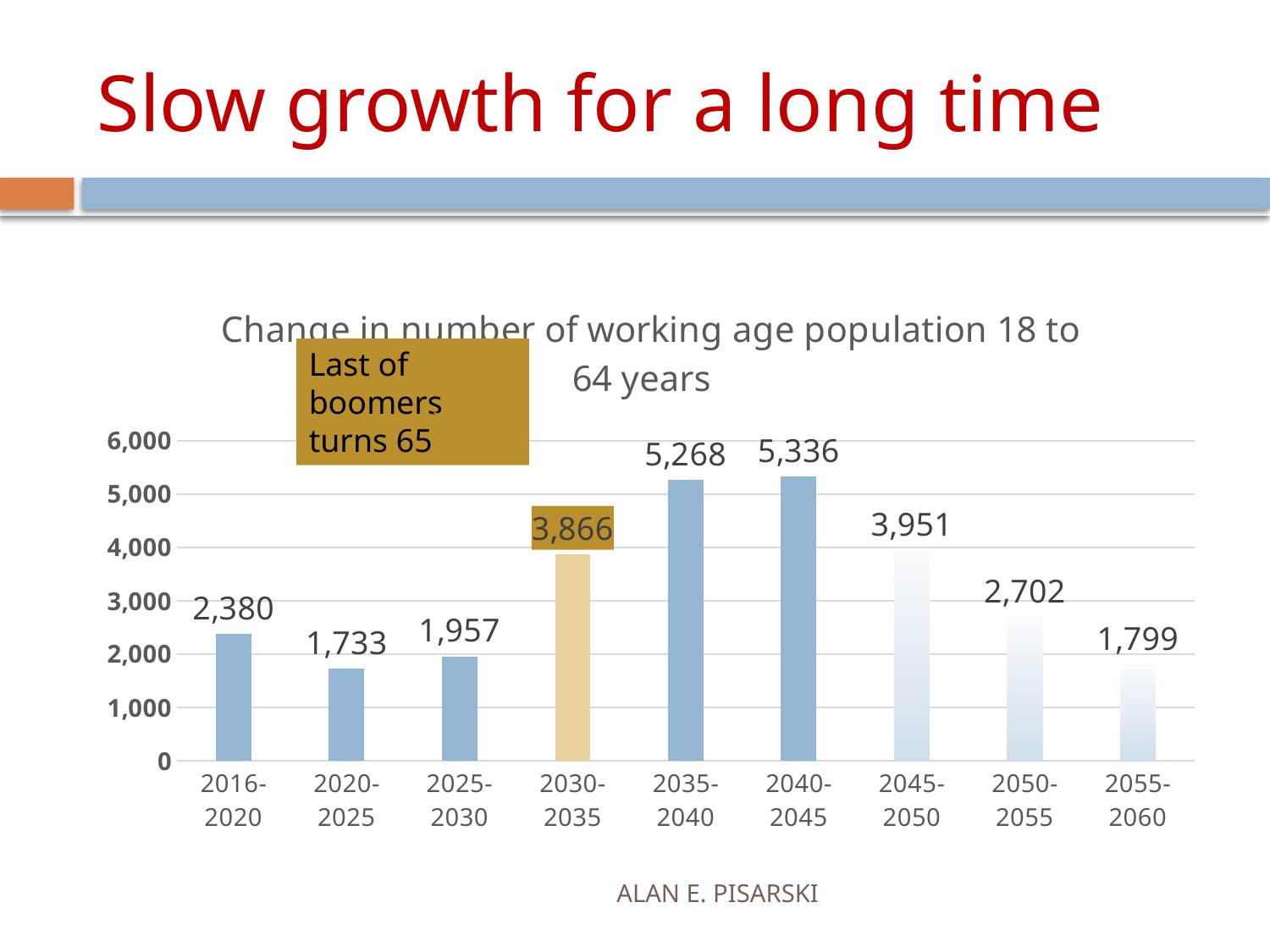
Which period has the highest value? 2040-2045 What is the value for 2016-2020? 2,380 Which is larger, the value for 2025-2030 or the value for 2055-2060? 2025-2030 What is the difference between the values for 2045-2050 and 2050-2055? 1,249 What kind of chart is shown? bar chart Which period has the lowest value? 2020-2025 What is the value for 2040-2045? 5,336 How many periods are shown on the x axis? 9 Is the value for 2030-2035 greater or less than 3,000? greater What is the title of the chart? Change in number of working age population 18 to 64 years What is the value for 2055-2060? 1,799 What is the difference between the values for 2040-2045 and 2035-2040? 68